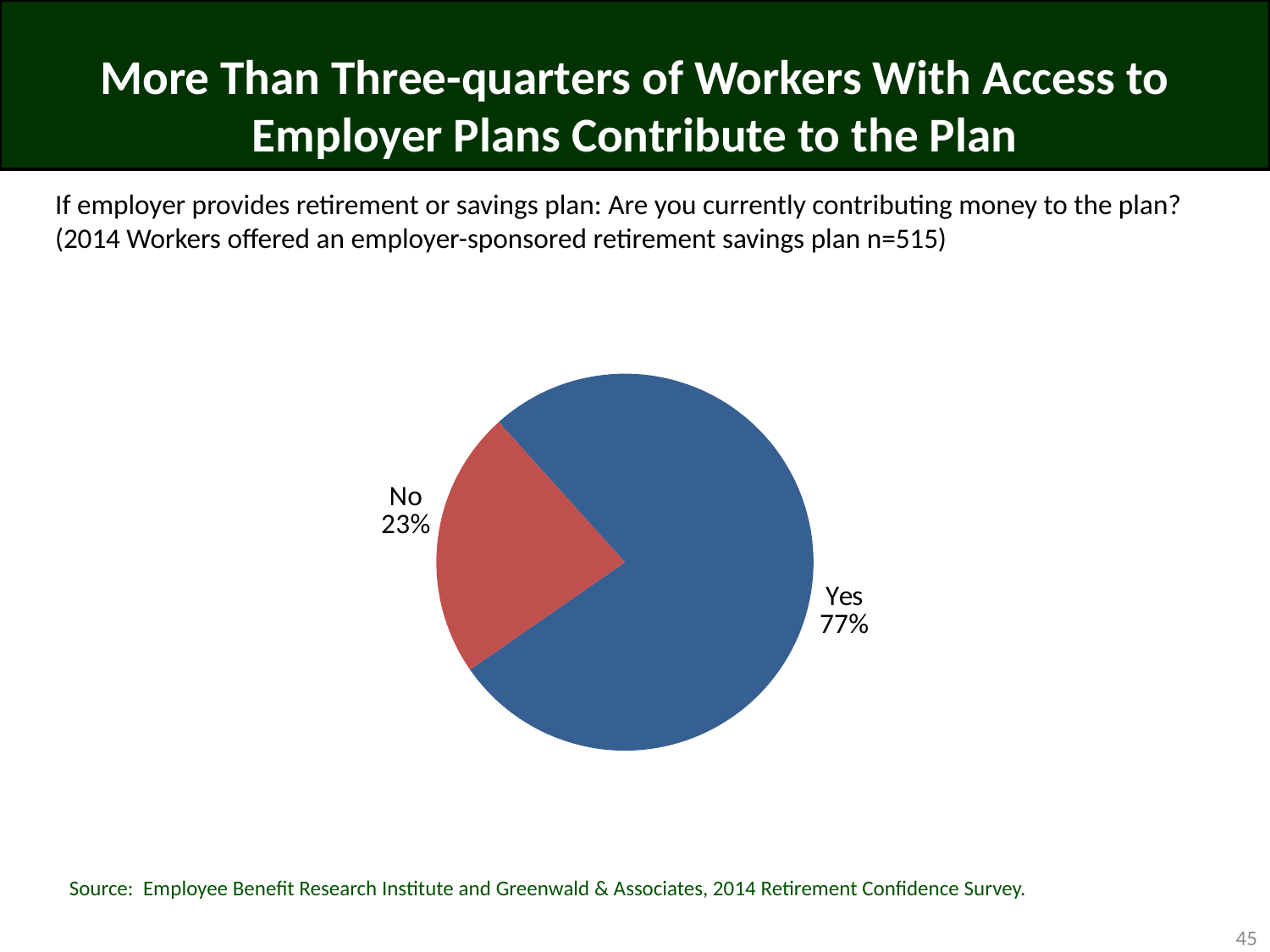
What colour is the No slice? red What share of the pie does the No slice represent? 23% Which slice of the pie is the smallest? No What is the difference in percentage points between the Yes and No slices? 54 What is the sample size (n) stated for the survey question shown in the chart? 515 How many slices does the pie chart have? 2 What percentage of workers answered Yes? 77% Which is larger, the Yes slice or the No slice? Yes What percentage of workers answered No? 23% What kind of chart is shown on the slide? pie chart What colour is the Yes slice? blue Which slice of the pie is the largest? Yes